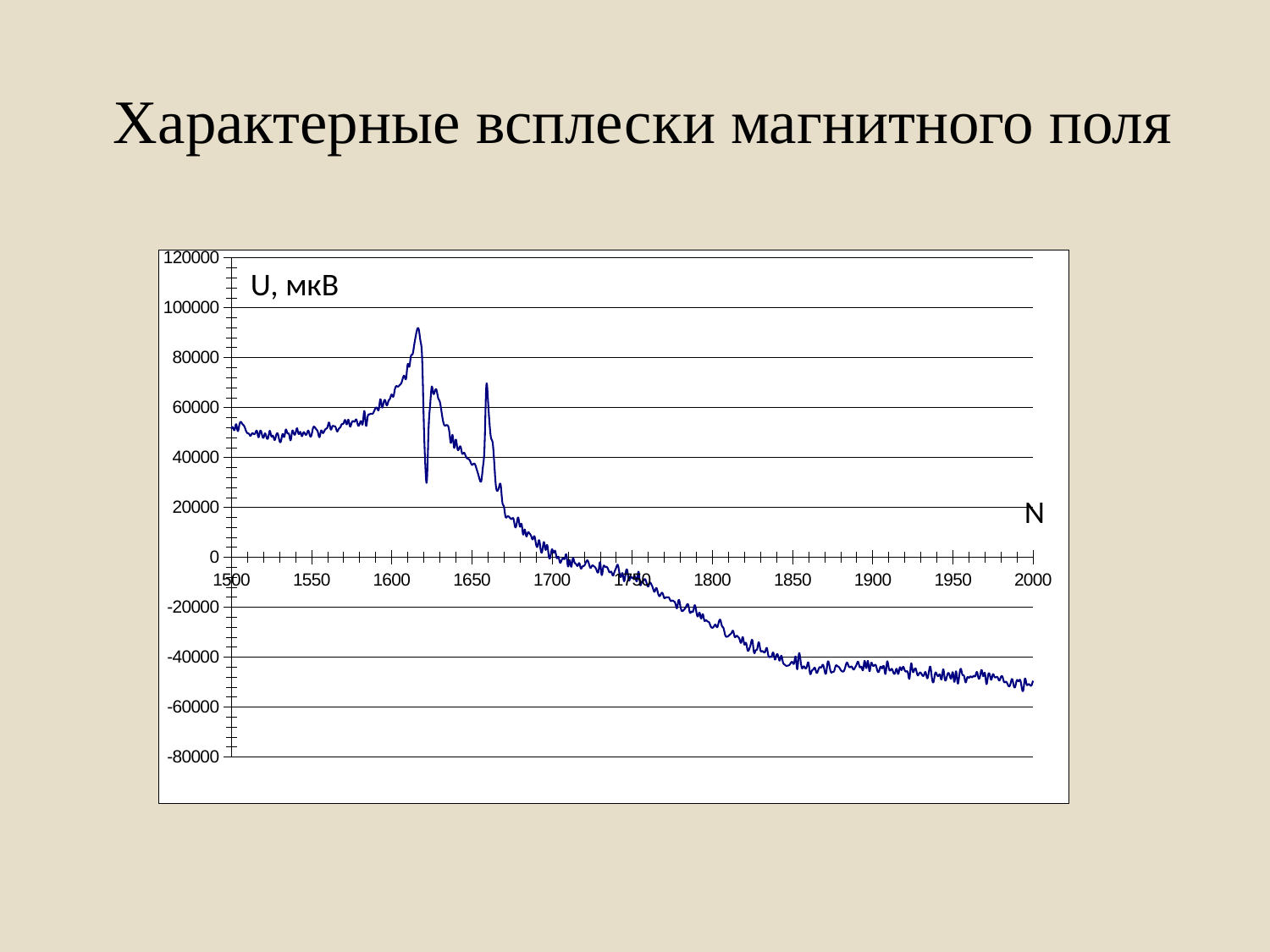
What label is shown on the vertical axis of the chart? U, мкВ Is the value of the line at N = 1500 greater or less than 40000? greater Is the value of the line at N = 1550 greater or less than 40000? greater Is the value of the line at N = 1800 greater or less than 0? less What is the title of the slide containing the chart? Характерные всплески магнитного поля Do the values of the line rise or fall between N = 1700 and N = 1850? fall What kind of chart is shown on the slide? line chart Which is larger, the value of the line at N = 1500 or at N = 2000? N = 1500 Do the values of the line rise or fall between N = 1550 and N = 1610? rise